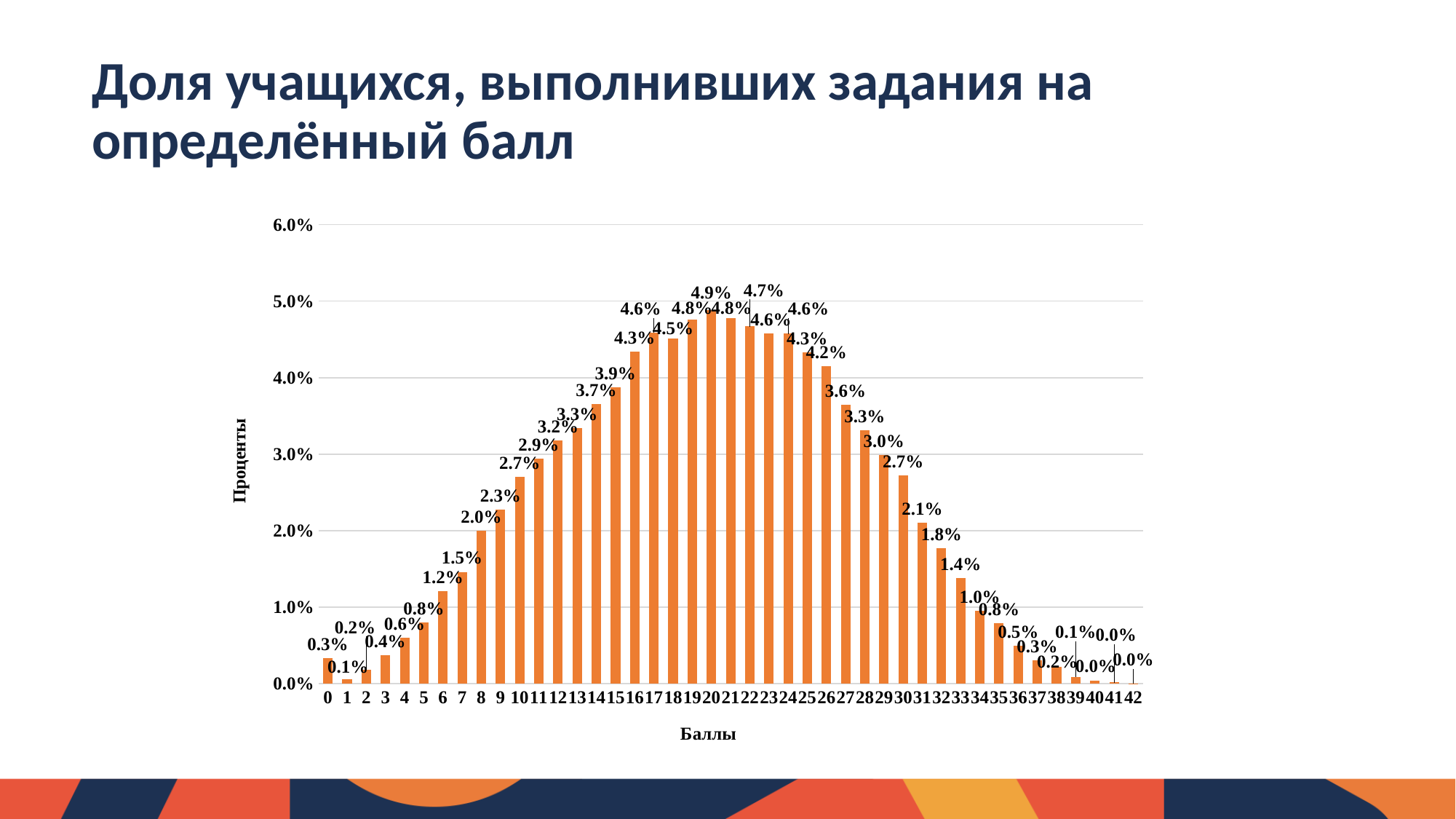
Do the values rise or fall as the score goes from 0 to 20? rise How many score categories are shown on the x axis? 43 What is the value shown for a score of 33? 1.4% What is the label of the y axis? Проценты What is the label of the x axis? Баллы What percentage of students scored 30 points? 2.7% Is the value for a score of 15 greater or less than 3.0%? greater What kind of chart is shown on the slide? bar chart Which score has the highest share of students? 20 What is the difference between the share for a score of 20 and the share for a score of 0? 4.6% Which has a larger share of students: a score of 10 or a score of 28? 28 What is the share of students who scored 8 points? 2.0%